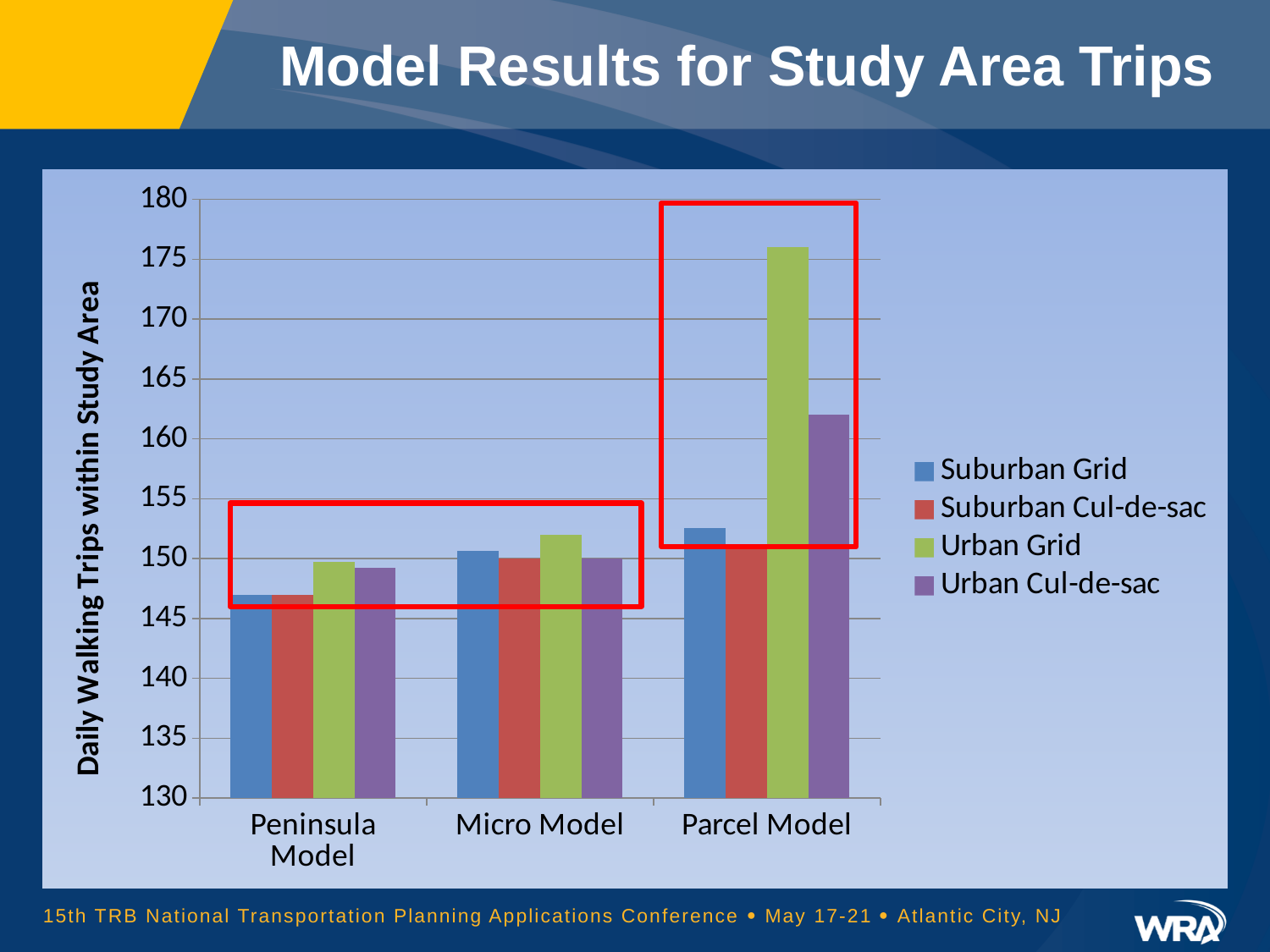
How many model categories are shown on the x axis? 3 Do the Urban Grid values rise or fall from the Peninsula Model to the Parcel Model? rise How many series does the legend list? 4 Which series has the highest value for the Parcel Model? Urban Grid For which model is the Urban Grid value lowest? Peninsula Model What is the title of the vertical axis? Daily Walking Trips within Study Area Is the value for Urban Grid in the Parcel Model greater or less than 170? greater Is the value for Urban Grid in the Micro Model greater or less than 150? greater Is the value for Urban Cul-de-sac in the Parcel Model greater or less than 155? greater In the Parcel Model, which is larger: Urban Grid or Urban Cul-de-sac? Urban Grid What kind of chart is shown on the slide? bar chart